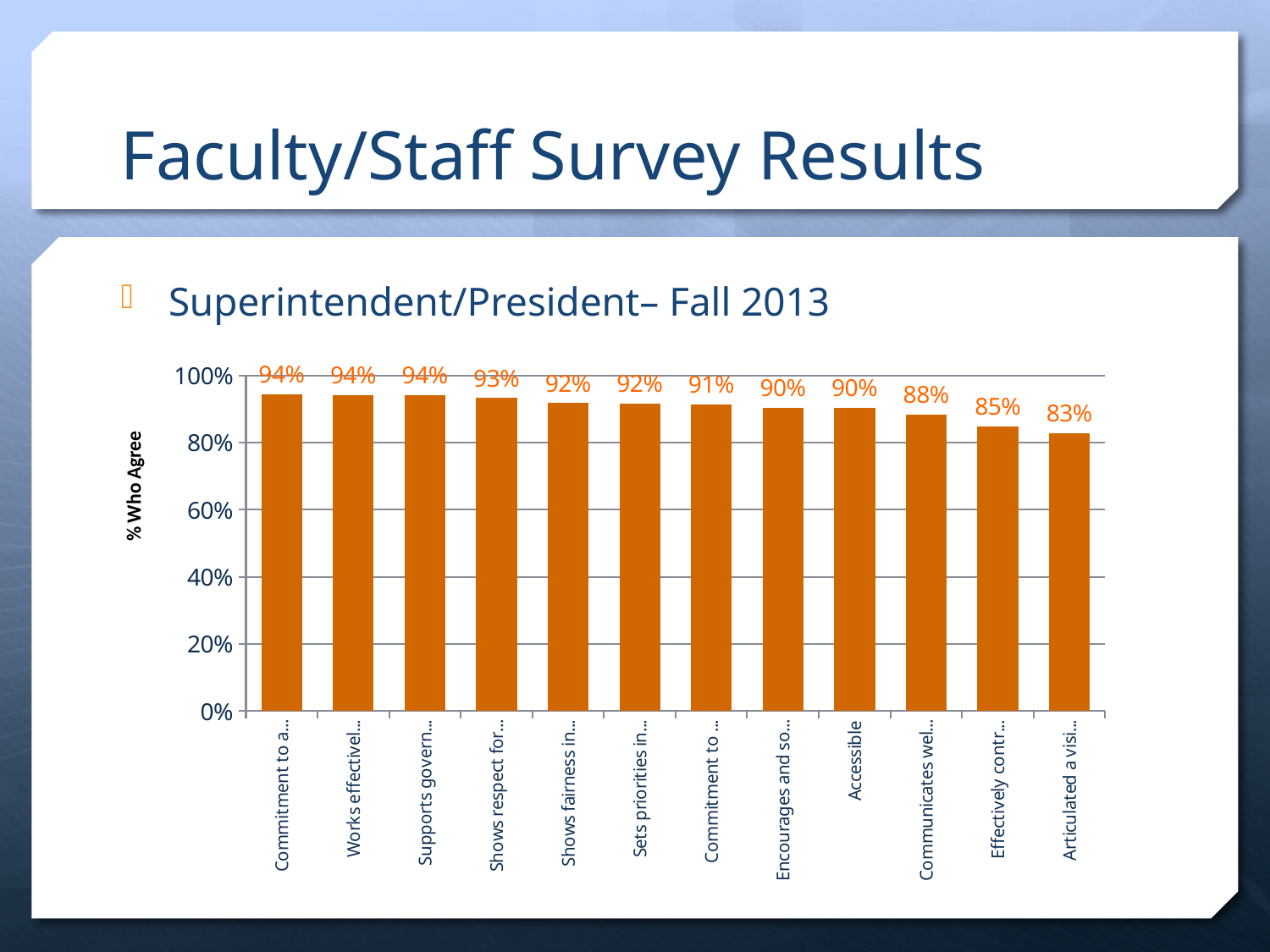
Do the values rise or fall moving from left to right along the x axis? Fall What is the value for Accessible? 90% What kind of chart is shown on the slide? Bar chart What is the title of the y axis? % Who Agree What is the highest value shown in the chart? 94% What is the value of the last (rightmost) bar, labelled 'Articulated a visi…'? 83% What is the value of the tenth bar from the left, labelled 'Communicates wel…'? 88% How many bars are plotted in the chart? 12 Which is larger: the value for Accessible or the value of the rightmost bar? Accessible How many bars have a value of 94%? 3 What is the lowest value shown in the chart? 83% What is the difference between the highest value (94%) and the lowest value (83%)? 11 percentage points